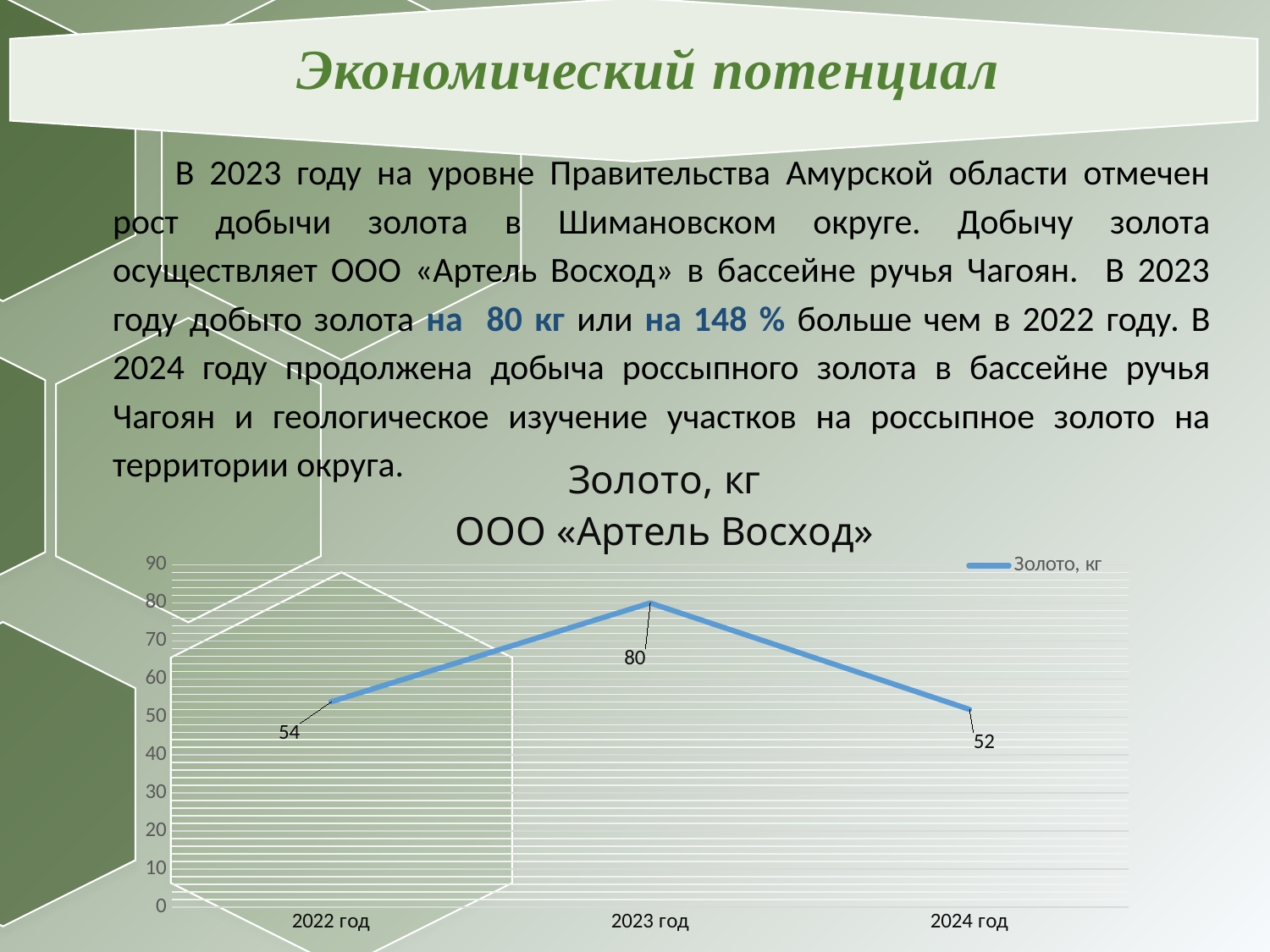
Which is larger, the value for 2022 год or the value for 2023 год? 2023 год Which year has the lowest value? 2024 год Which year has the highest value? 2023 год What is the difference between the values for 2023 год and 2024 год? 28 What is the value for 2022 год? 54 What is the difference between the values for 2023 год and 2022 год? 26 What kind of chart is shown on the slide? line chart What is the value for 2023 год? 80 How many data points are plotted on the chart? 3 What is the title of the chart? Золото, кг ООО «Артель Восход» How many series does the legend list? 1 What is the value for 2024 год? 52